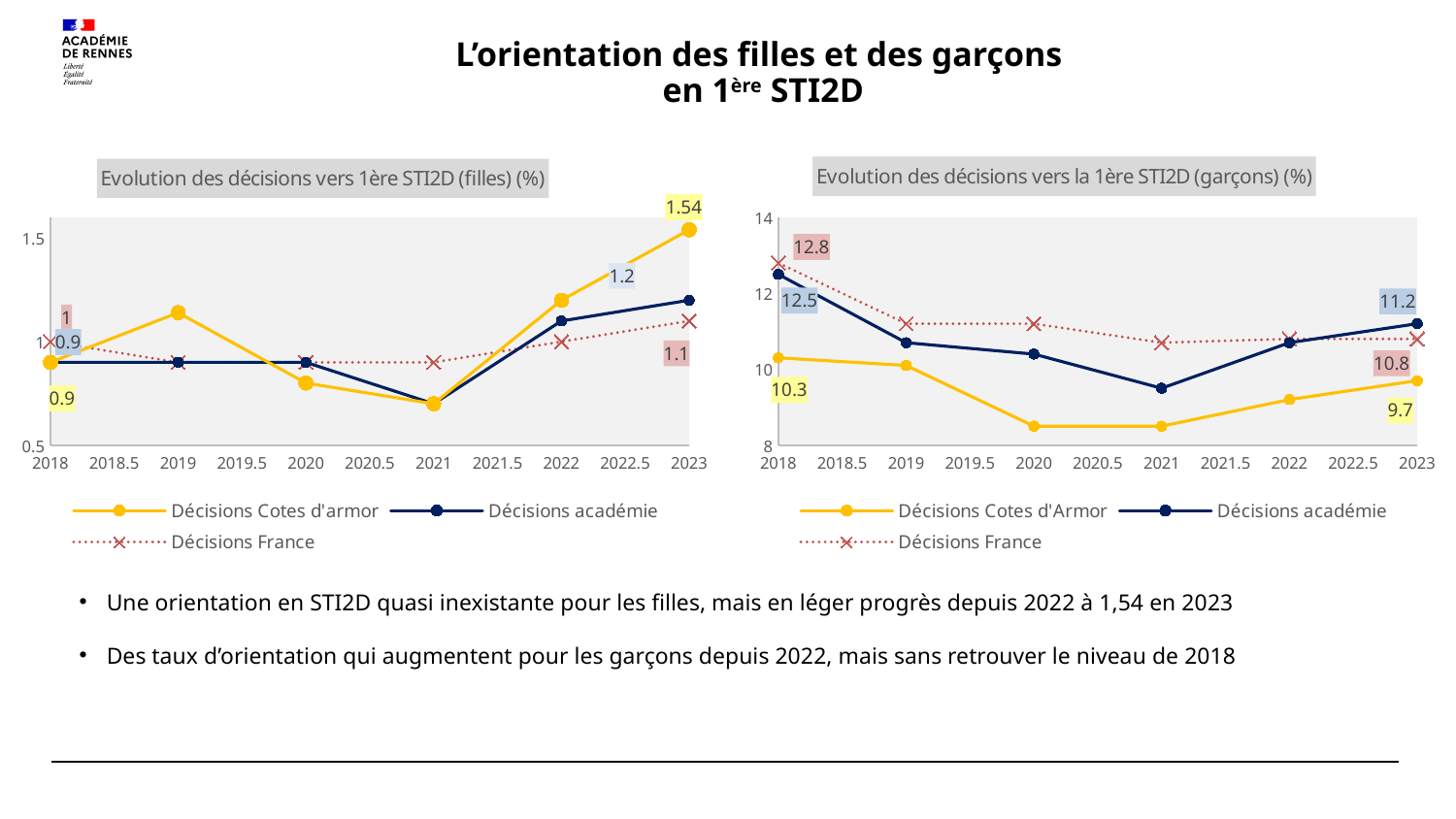
In the right chart (garçons), what is the difference between Décisions académie in 2018 and in 2023? 1.3 In the right chart (garçons), what is the value for Décisions France in 2018? 12.8 In the left chart (filles), by how much did Décisions Cotes d'armor increase from 2018 to 2023? 0.64 In the right chart (garçons), which series has the highest value in 2023? Décisions académie In the right chart (garçons), does the Décisions Cotes d'Armor line rise or fall from 2018 to 2021? fall In the right chart (garçons), is the value for Décisions Cotes d'Armor in 2020 greater or less than 10? less In the right chart (garçons), which is larger in 2018: Décisions académie or Décisions Cotes d'Armor? Décisions académie How many series does the legend of the left chart (filles) list? 3 In the left chart (filles), what is the value for Décisions Cotes d'armor in 2023? 1.54 In the left chart (filles), what is the value for Décisions France in 2023? 1.1 In the right chart (garçons), what is the value for Décisions académie in 2023? 11.2 What kind of chart is the right chart (garçons)? Line chart